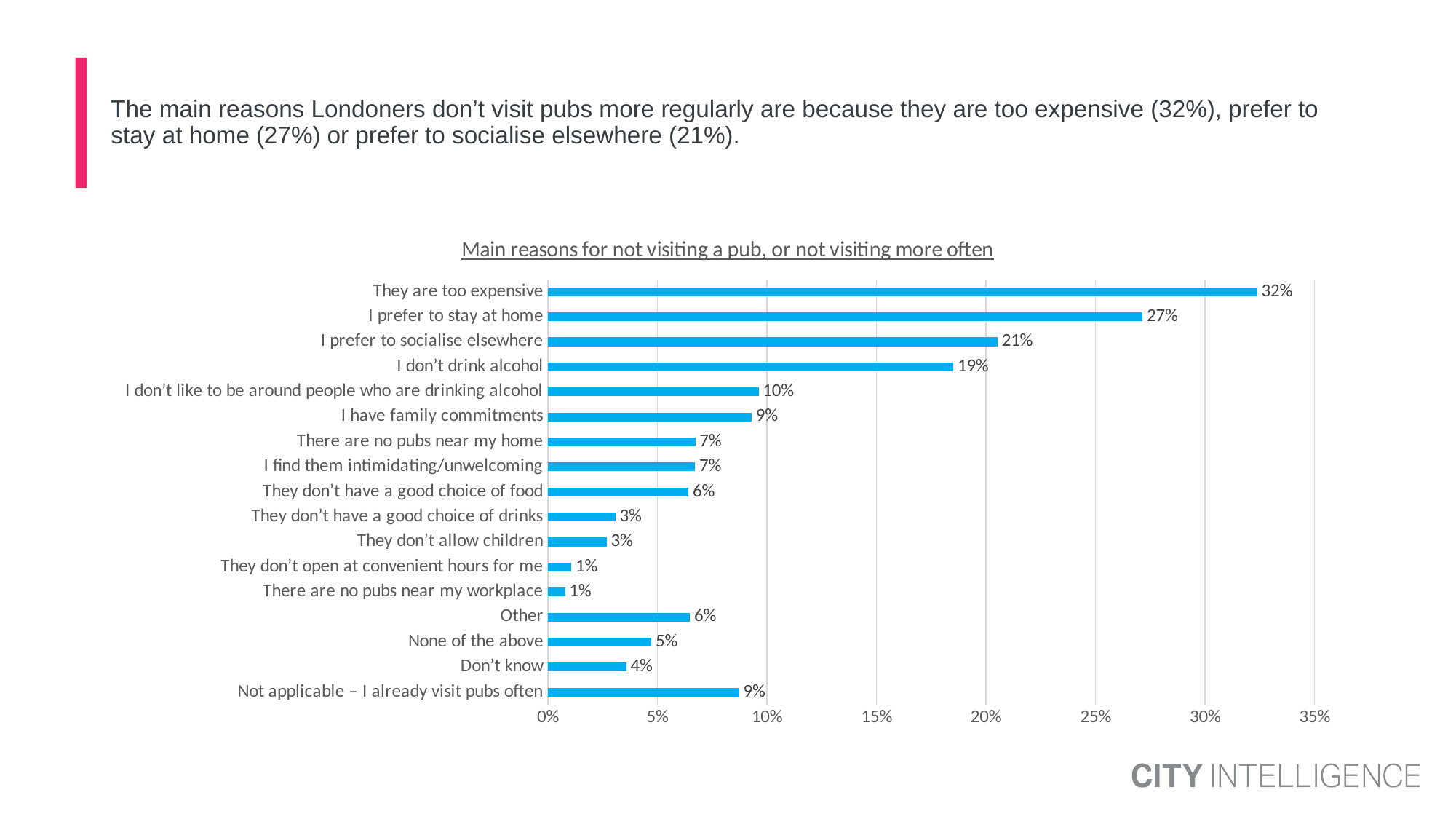
Is the value for 'I prefer to stay at home' greater or less than 25%? greater What is the title of the chart? Main reasons for not visiting a pub, or not visiting more often Which is larger: 'I don't like to be around people who are drinking alcohol' or 'They don't have a good choice of food'? I don't like to be around people who are drinking alcohol What is the value for 'I have family commitments'? 9% What is the value for 'I don't drink alcohol'? 19% Which reason has the highest percentage? They are too expensive What kind of chart is shown on the slide? Bar chart How many categories are shown in the chart? 17 What is the highest value shown on the x axis? 35% What is the difference between 'I prefer to stay at home' and 'I prefer to socialise elsewhere'? 6% What is the value for 'Not applicable – I already visit pubs often'? 9% What percentage of Londoners say pubs are too expensive as a reason for not visiting? 32%